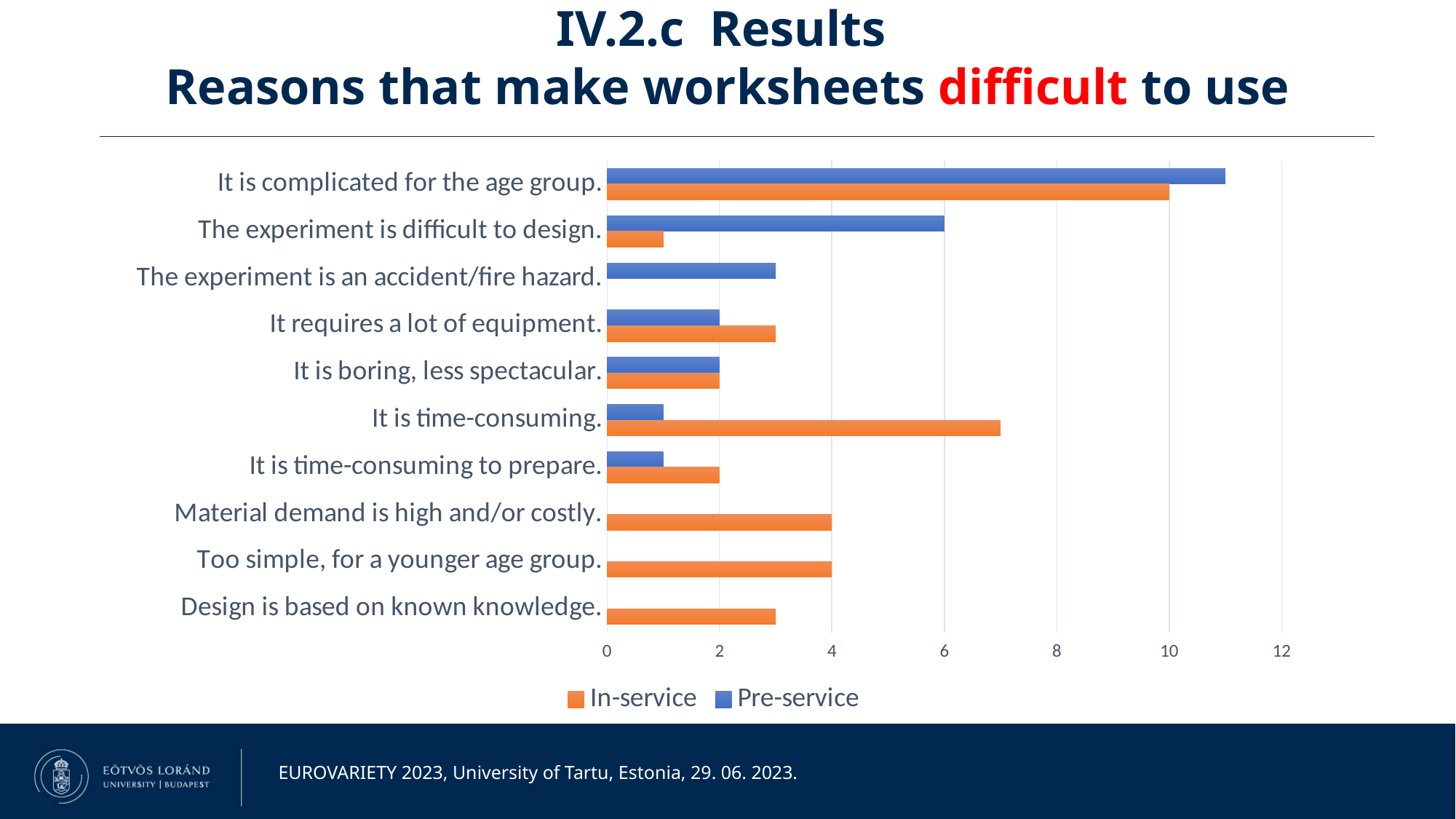
Which reason has the highest In-service value? It is complicated for the age group. What is the Pre-service value for "The experiment is difficult to design."? 6 How many series does the legend list? 2 What kind of chart is shown on the slide? bar chart For "It is time-consuming.", which series has the larger value, In-service or Pre-service? In-service Which reason has the highest Pre-service value? It is complicated for the age group. How many reasons (categories) are listed on the chart? 10 What is the In-service value for "It is complicated for the age group."? 10 Is the In-service value for "It is time-consuming." greater or less than 6? greater What is the Pre-service value for "It is boring, less spectacular."? 2 What is the In-service value for "Material demand is high and/or costly."? 4 Is the Pre-service value for "It is complicated for the age group." greater or less than 10? greater